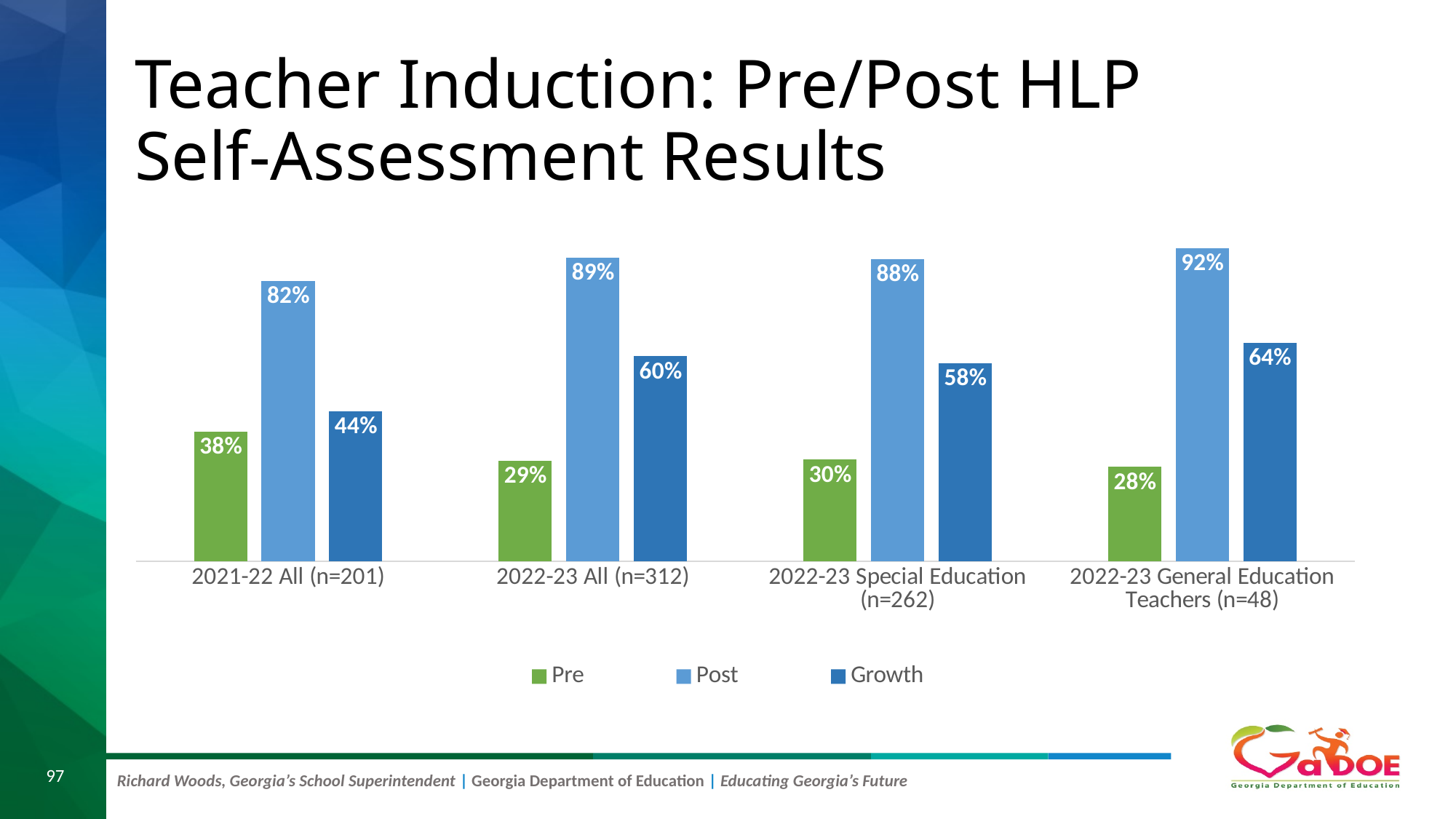
What is the Pre value for 2022-23 General Education Teachers (n=48)? 28% Which series is shown in green in the legend? Pre Which category has the highest Post value? 2022-23 General Education Teachers (n=48) Which is larger: the Growth value for 2022-23 All (n=312) or for 2022-23 Special Education (n=262)? 2022-23 All (n=312) What is the Growth value for 2022-23 Special Education (n=262)? 58% What kind of chart is shown on the slide? Bar chart How many series does the legend list? 3 How many categories are shown on the x axis? 4 What is the difference between the Post and Pre values for 2021-22 All (n=201)? 44% What is the Post value for 2022-23 All (n=312)? 89% Which category has the lowest Growth value? 2021-22 All (n=201) What is the difference between the Growth values for 2022-23 General Education Teachers (n=48) and 2021-22 All (n=201)? 20%